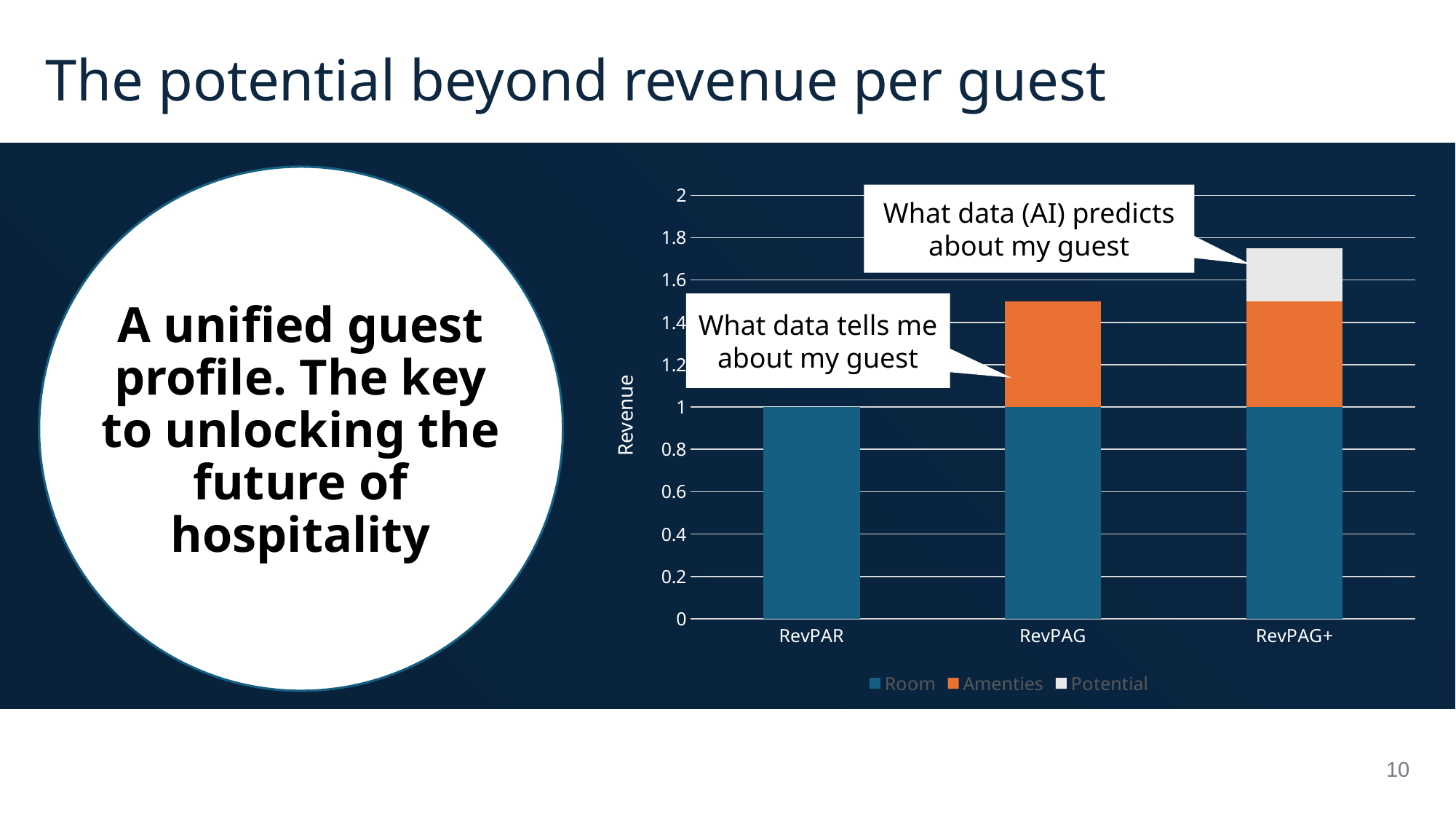
What is the value of the Room series for RevPAR? 1 What kind of chart is shown on the slide? stacked bar chart Which category has the lowest total bar? RevPAR Which category has the highest total bar? RevPAG+ What is the value of the Room series for RevPAG+? 1 Which is larger, the total for RevPAG or the total for RevPAR? RevPAG What is the total height of the RevPAR bar? 1 How many categories are shown on the x axis of the chart? 3 Is the total for RevPAG+ greater or less than 1.8? less What is the label on the vertical axis of the chart? Revenue How many series does the chart legend list? 3 Is the total for RevPAG greater or less than 1.4? greater